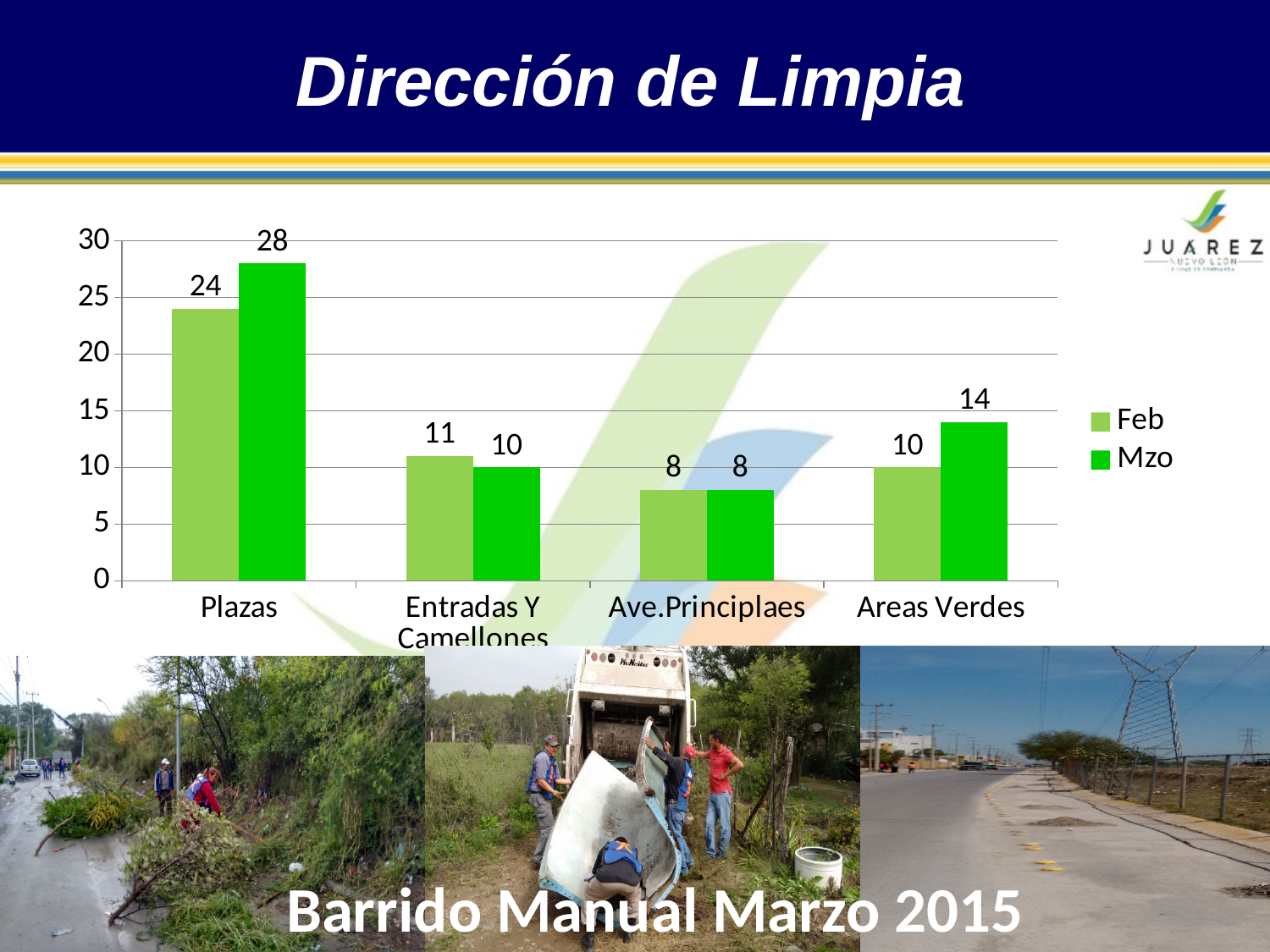
Which category has the lowest Feb value? Ave.Principlaes What is the difference between the Mzo and Feb values for Plazas? 4 What is the Mzo value for Entradas Y Camellones? 10 Which is larger for Entradas Y Camellones, the Feb value or the Mzo value? Feb Is the Mzo value for Plazas greater or less than 25? greater What is the Feb value for Plazas? 24 What kind of chart is shown on the slide? bar chart What are the two series named in the legend? Feb and Mzo Which category has the highest Mzo value? Plazas How many series does the legend list? 2 How many categories are shown on the x axis? 4 What is the Mzo value for Areas Verdes? 14